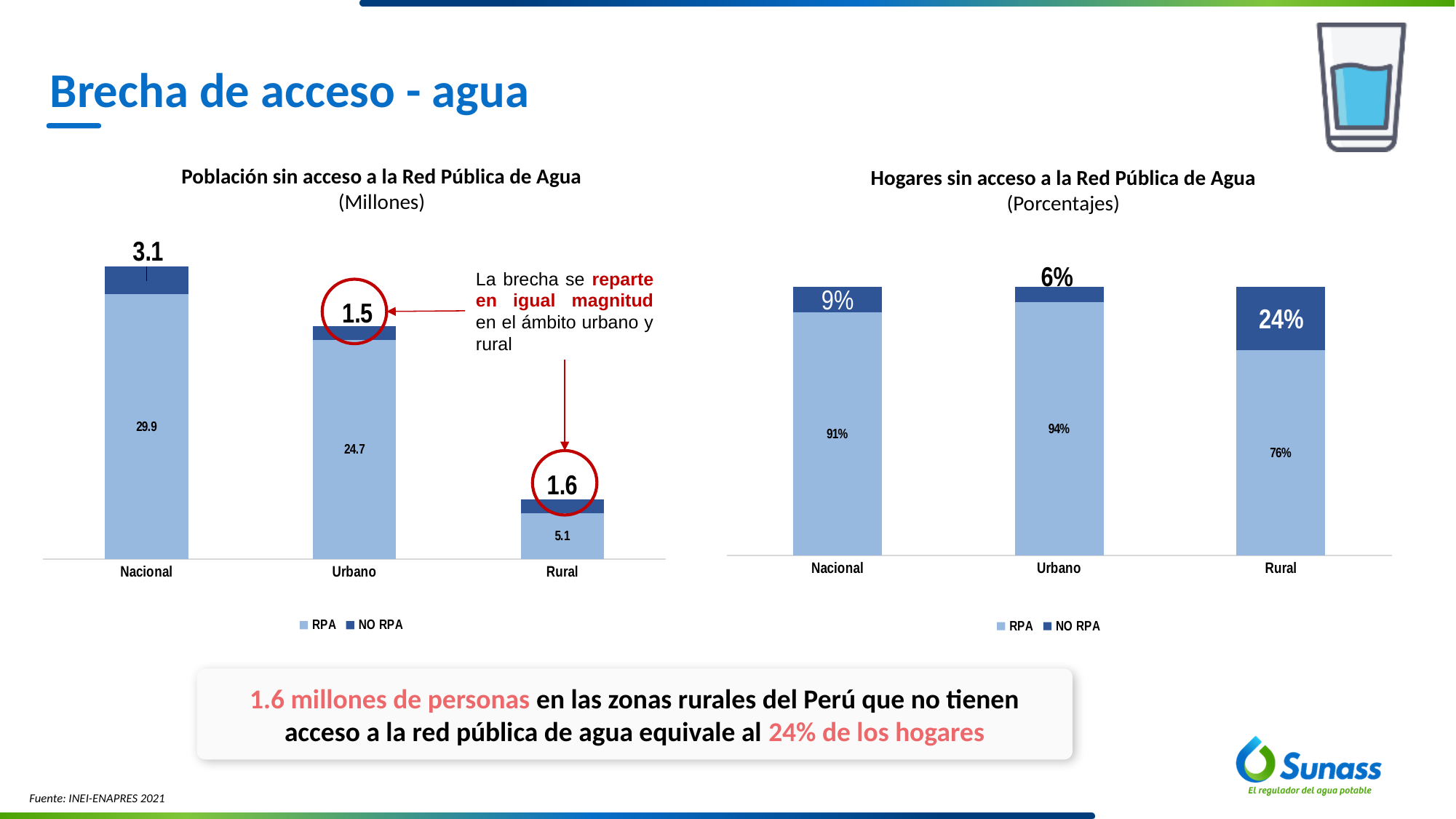
In the left chart (Población sin acceso a la Red Pública de Agua), which category has the lowest RPA value? Rural In the left chart (Población sin acceso a la Red Pública de Agua), what is the NO RPA value for Rural? 1.6 In the right chart (Hogares sin acceso a la Red Pública de Agua), what is the NO RPA percentage for Rural? 24% How many series does the legend of the right chart (Hogares sin acceso a la Red Pública de Agua) list? 2 In the right chart (Hogares sin acceso a la Red Pública de Agua), is the RPA percentage for Nacional larger or smaller than for Rural? larger In the left chart (Población sin acceso a la Red Pública de Agua), what is the RPA value for Nacional? 29.9 In the left chart (Población sin acceso a la Red Pública de Agua), what is the NO RPA value for Urbano? 1.5 In the left chart (Población sin acceso a la Red Pública de Agua), what is the total of the stacked bar for Nacional? 33.0 In the right chart (Hogares sin acceso a la Red Pública de Agua), which category has the highest NO RPA percentage? Rural What kind of chart is the left chart (Población sin acceso a la Red Pública de Agua)? Stacked bar chart In the left chart (Población sin acceso a la Red Pública de Agua), what is the difference between the RPA values for Urbano and Rural? 19.6 In the right chart (Hogares sin acceso a la Red Pública de Agua), what is the RPA percentage for Urbano? 94%